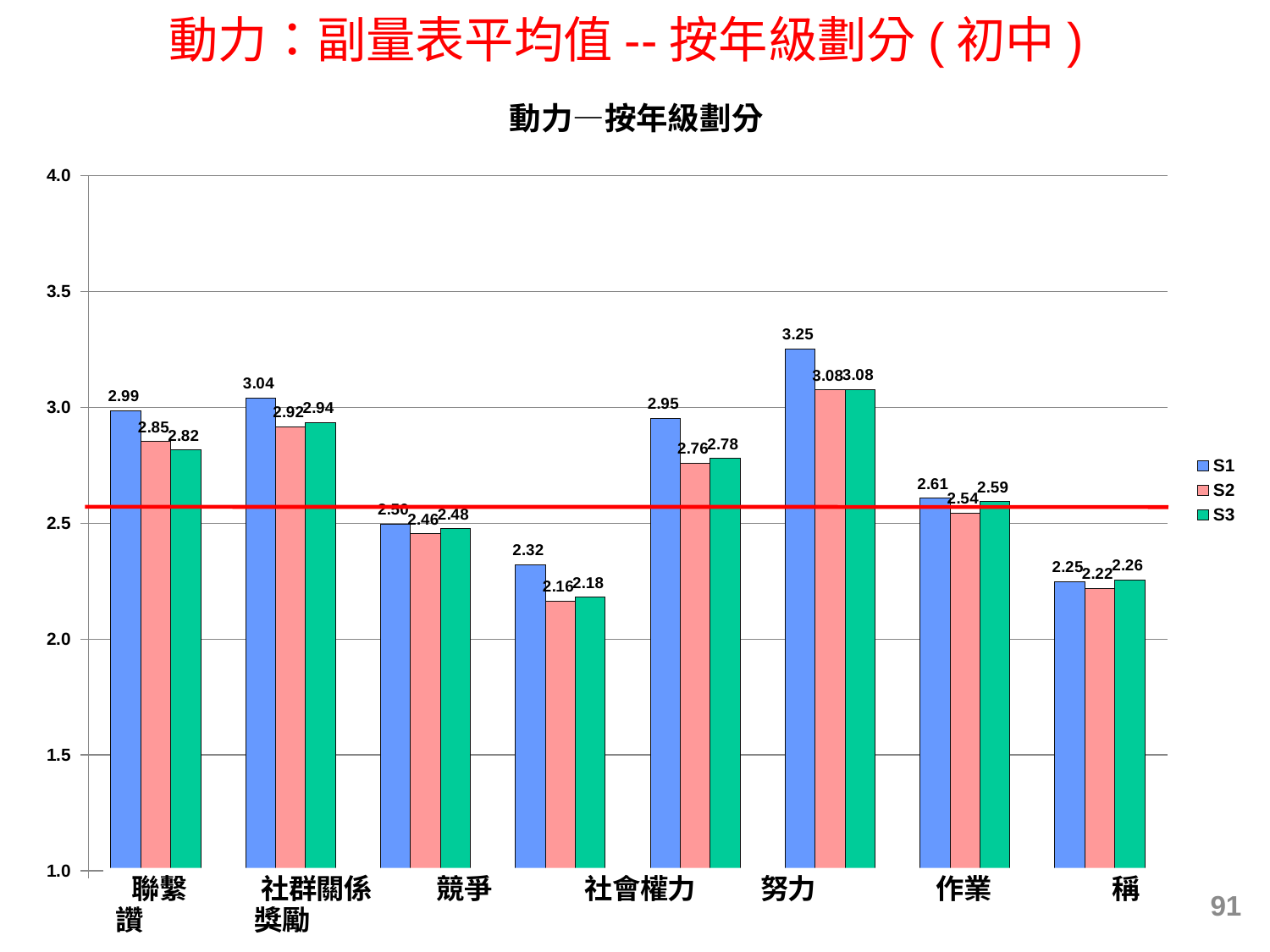
How many category groups are shown on the x axis? 8 What is the difference between the S1 and S2 values for 社會權力? 0.16 What kind of chart is shown on the slide? bar chart How many series does the legend list? 3 Which category has the lowest S2 value? 社會權力 What is the S1 value for 競爭? 2.50 What is the S2 value for 社會權力? 2.16 Which is larger for 努力, the S1 value or the S2 value? S1